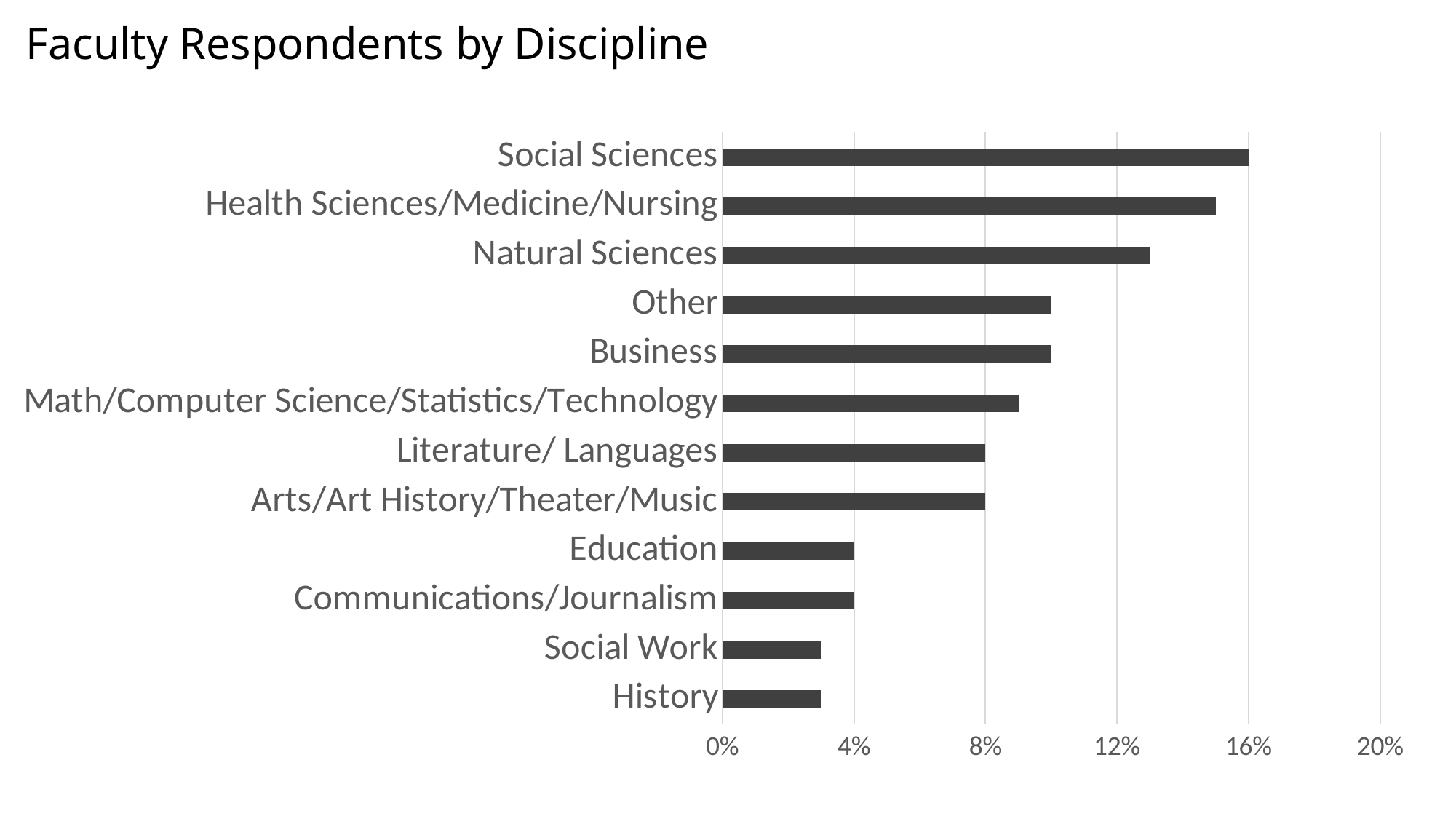
How many disciplines are shown in the chart? 12 What is the value for Literature/ Languages? 8% What is the title of the chart? Faculty Respondents by Discipline What is the difference between the values for Social Sciences and Education? 12% What is the value for Social Sciences? 16% Which discipline has the highest share of faculty respondents? Social Sciences Is the value for Other greater or less than 8%? greater Is the value for Health Sciences/Medicine/Nursing greater or less than 12%? greater Is the value for Social Work greater or less than 4%? less What kind of chart is shown on the slide? bar chart Which is larger, the value for Natural Sciences or the value for Business? Natural Sciences What is the value for Education? 4%